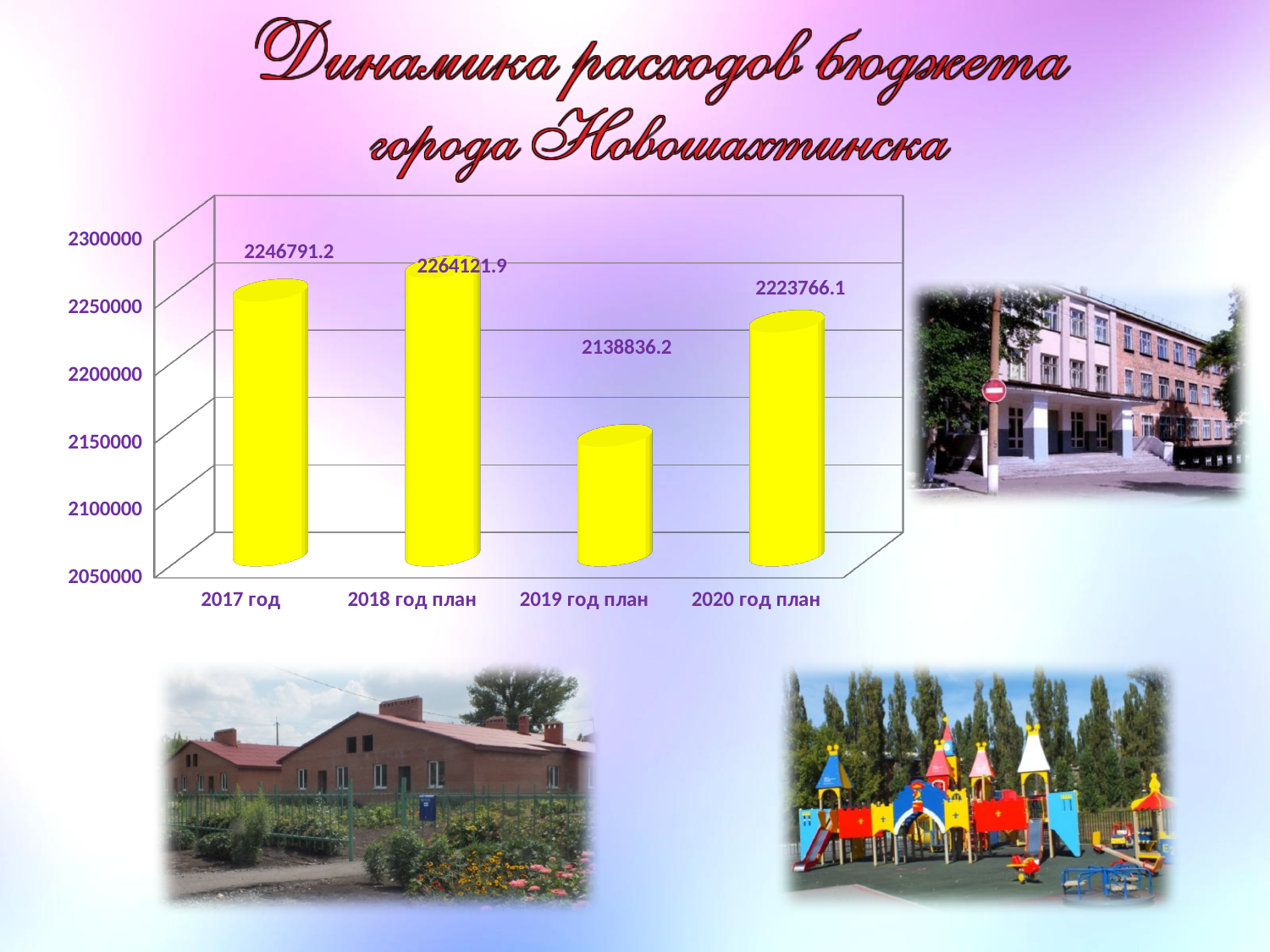
What is the value for 2018 год план? 2264121.9 Is the value for 2019 год план greater or less than 2150000? less Which category has the highest value? 2018 год план What is the value for 2020 год план? 2223766.1 Which category has the lowest value? 2019 год план What is the difference between the values for 2018 год план and 2017 год? 17330.7 What is the value for 2017 год? 2246791.2 Which is larger, the value for 2017 год or the value for 2020 год план? 2017 год What is the difference between the values for 2020 год план and 2019 год план? 84929.9 What is the value for 2019 год план? 2138836.2 What kind of chart is shown on the slide? bar chart How many categories are shown on the x axis? 4